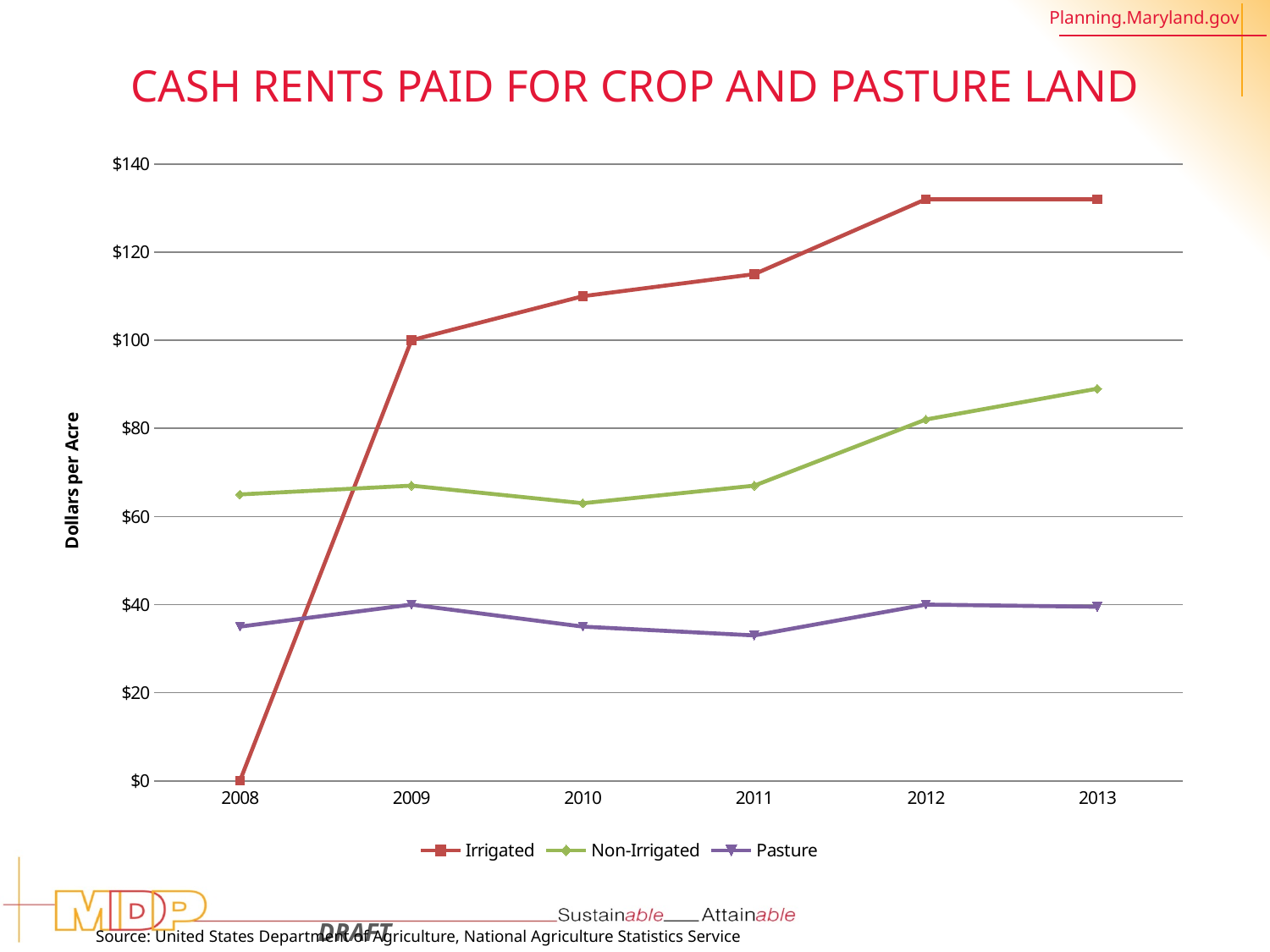
Does the Irrigated series rise or fall from 2008 to 2012? rise How many years are shown on the x axis? 6 What is the title of the chart? CASH RENTS PAID FOR CROP AND PASTURE LAND What is the label of the y axis? Dollars per Acre How many series does the legend list? 3 Which series has the highest value in 2013? Irrigated What is the value for Irrigated in 2008? $0 Which series has the lowest value in 2011? Pasture What is the value for Irrigated in 2009? $100 What kind of chart is shown on the slide? line chart Is the value for Non-Irrigated in 2010 greater or less than $80? less Is the value for Irrigated in 2012 greater or less than $120? greater